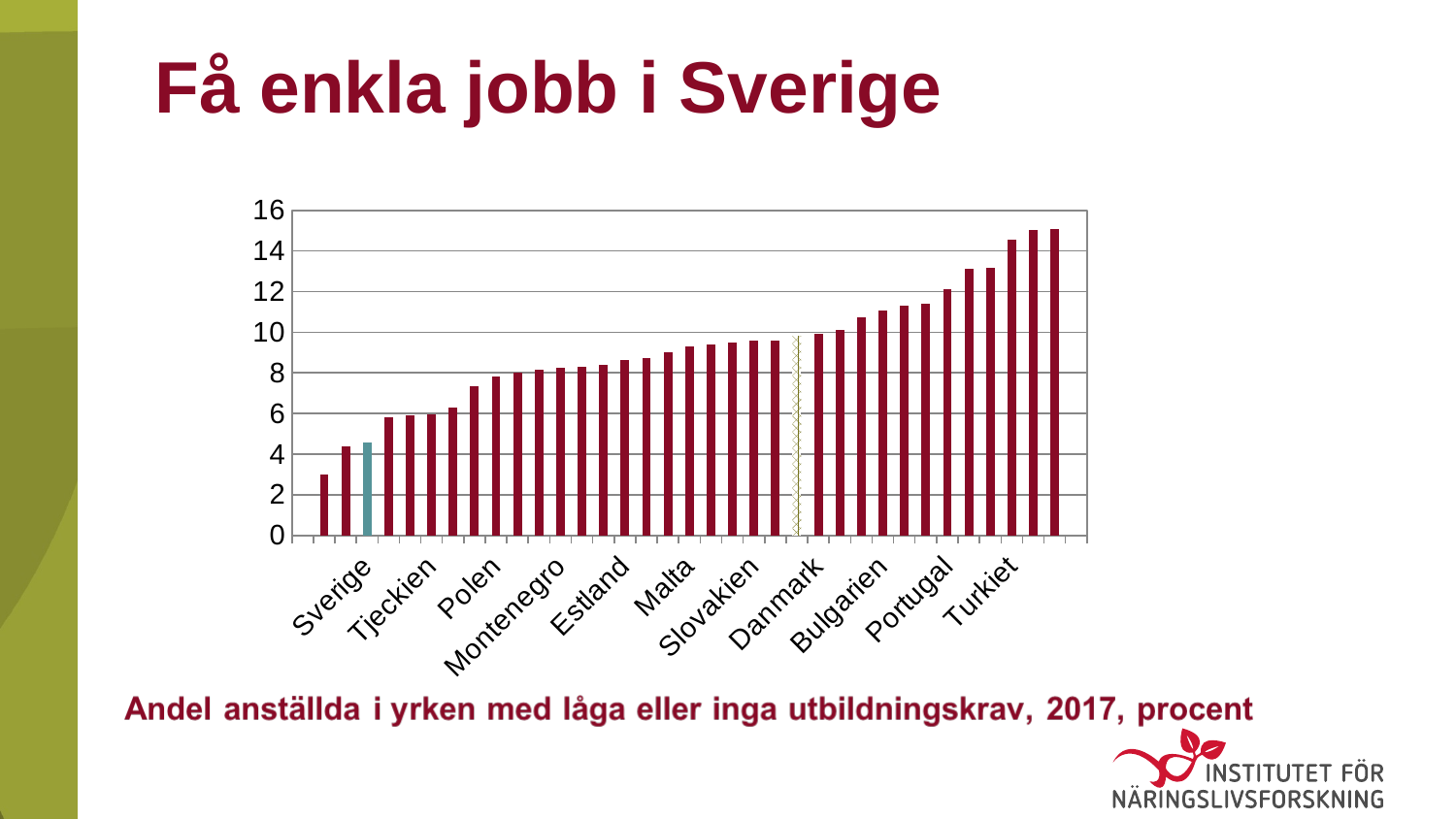
Which has the larger value, Polen or Portugal? Portugal Is the value for Danmark greater or less than 8? greater What kind of chart is shown on the slide? bar chart Which has the larger value, Sverige or Danmark? Danmark What is the title of the slide? Få enkla jobb i Sverige Do the bar values rise or fall from left to right along the x axis? rise Is the value for Turkiet greater or less than 12? greater Is the value for Sverige greater or less than 6? less What colour is the bar for Sverige, which differs from the other bars? teal Which has the larger value, Sverige or Turkiet? Turkiet